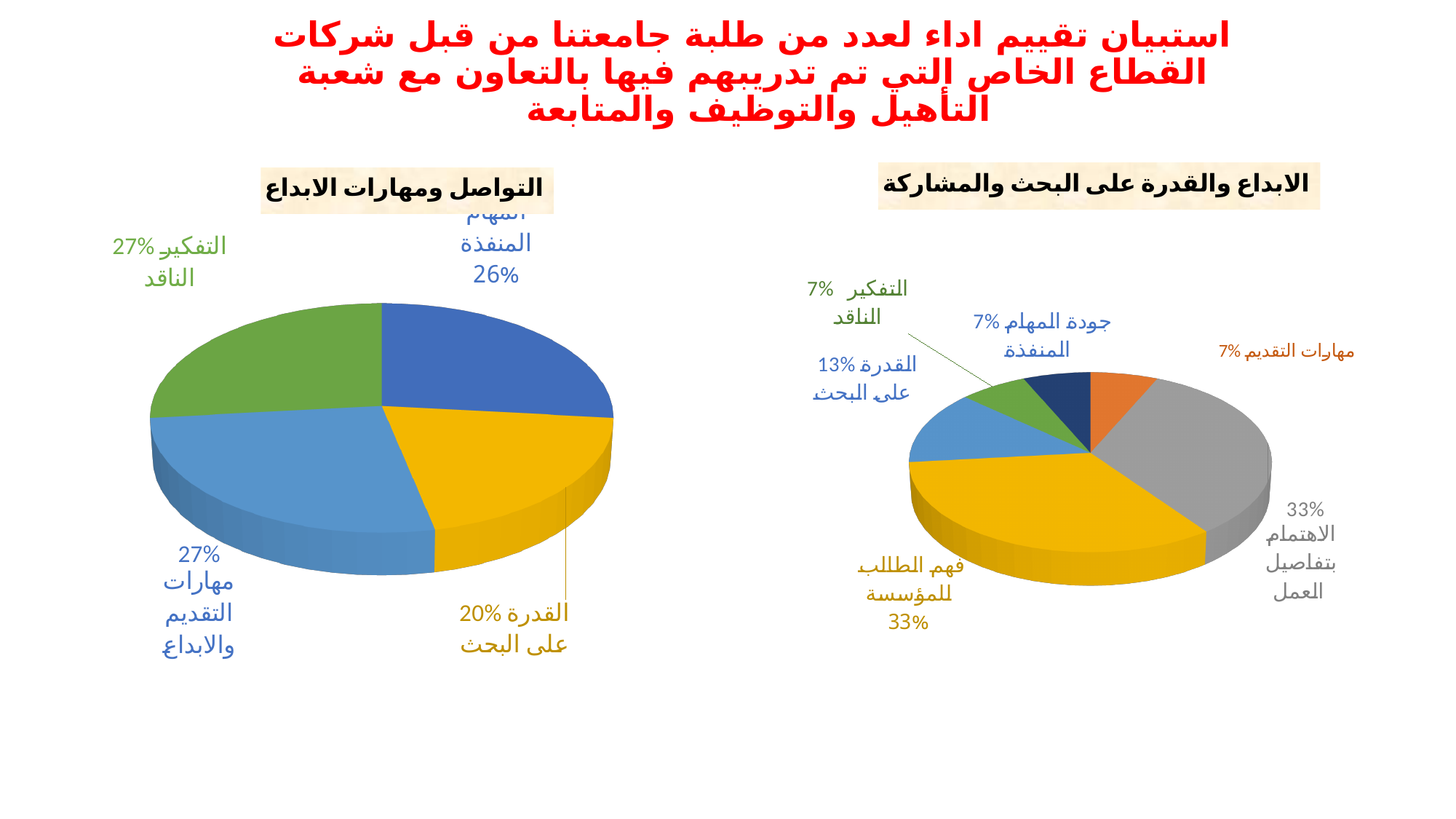
In the chart titled "الابداع والقدرة على البحث والمشاركة", what colour is the slice for فهم الطالب للمؤسسة? Yellow In the chart titled "الابداع والقدرة على البحث والمشاركة", what percentage is shown for القدرة على البحث? 13% In the chart titled "التواصل ومهارات الابداع", what percentage is shown for القدرة على البحث? 20% In the chart titled "التواصل ومهارات الابداع", what is the difference between the share for مهارات التقديم والابداع and the share for القدرة على البحث? 7% In the chart titled "الابداع والقدرة على البحث والمشاركة", how many slices does the pie have? 6 In the chart titled "التواصل ومهارات الابداع", which category has the smallest share? القدرة على البحث In the chart titled "التواصل ومهارات الابداع", how many slices does the pie have? 4 In the chart titled "التواصل ومهارات الابداع", what percentage is shown for التفكير الناقد? 27% In the chart titled "الابداع والقدرة على البحث والمشاركة", what percentage is shown for الاهتمام بتفاصيل العمل? 33% What type of chart is the chart titled "الابداع والقدرة على البحث والمشاركة"? Pie chart In the chart titled "الابداع والقدرة على البحث والمشاركة", which is larger: the share for القدرة على البحث or the share for جودة المهام المنفذة? القدرة على البحث In the chart titled "الابداع والقدرة على البحث والمشاركة", what is the difference between the share for فهم الطالب للمؤسسة and the share for مهارات التقديم? 26%